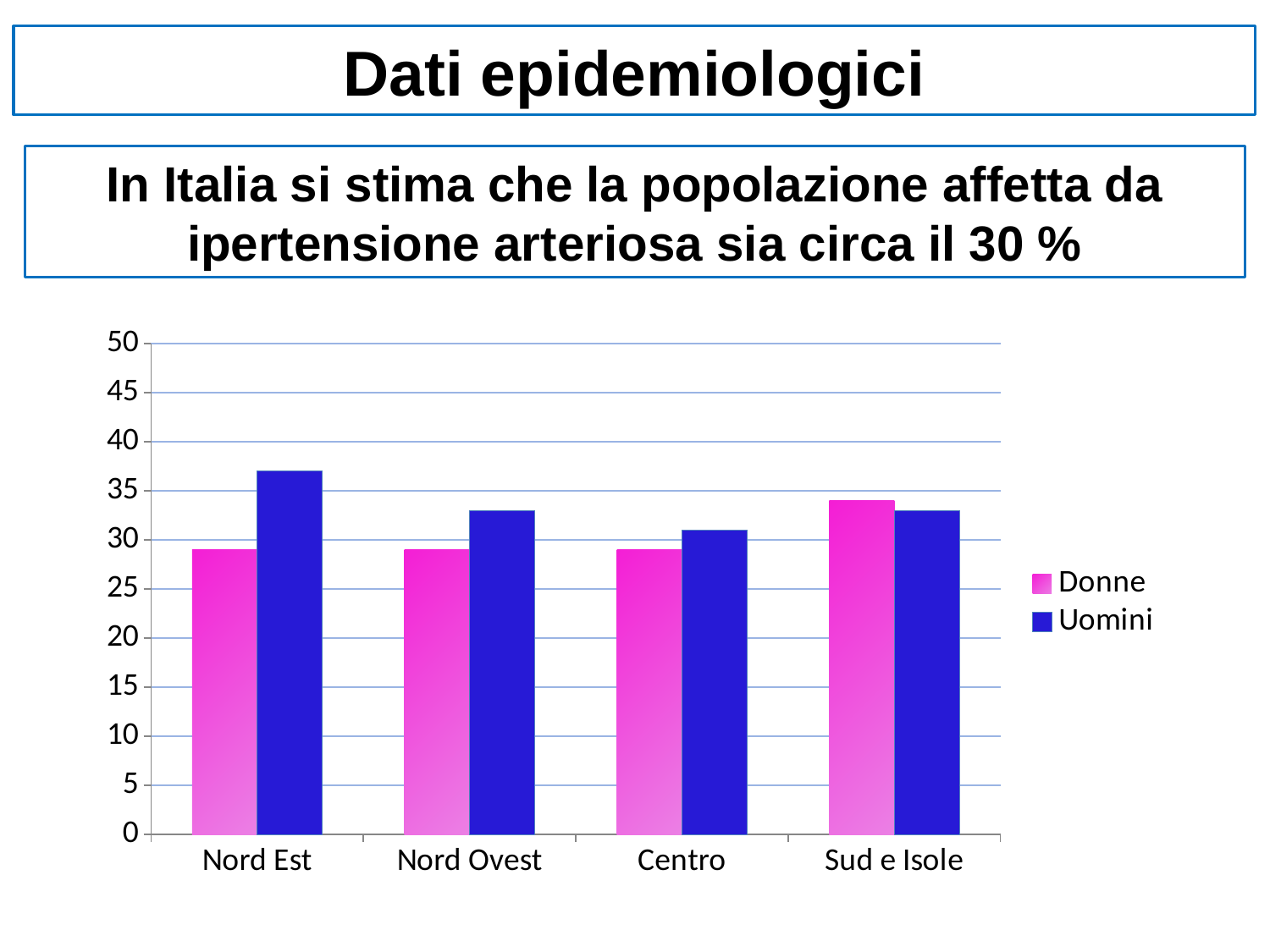
How many regions are shown on the x axis? 4 How many series does the legend list? 2 What kind of chart is shown on the slide? bar chart Is the Uomini value for Nord Est greater or less than 35? greater Is the Donne value for Sud e Isole greater or less than 30? greater In Nord Est, which is larger, the Donne value or the Uomini value? Uomini For which region is the Uomini value highest? Nord Est Is the Uomini value for Centro greater or less than 35? less For which region is the Donne value highest? Sud e Isole Which series is shown in pink? Donne What are the two series named in the legend? Donne and Uomini